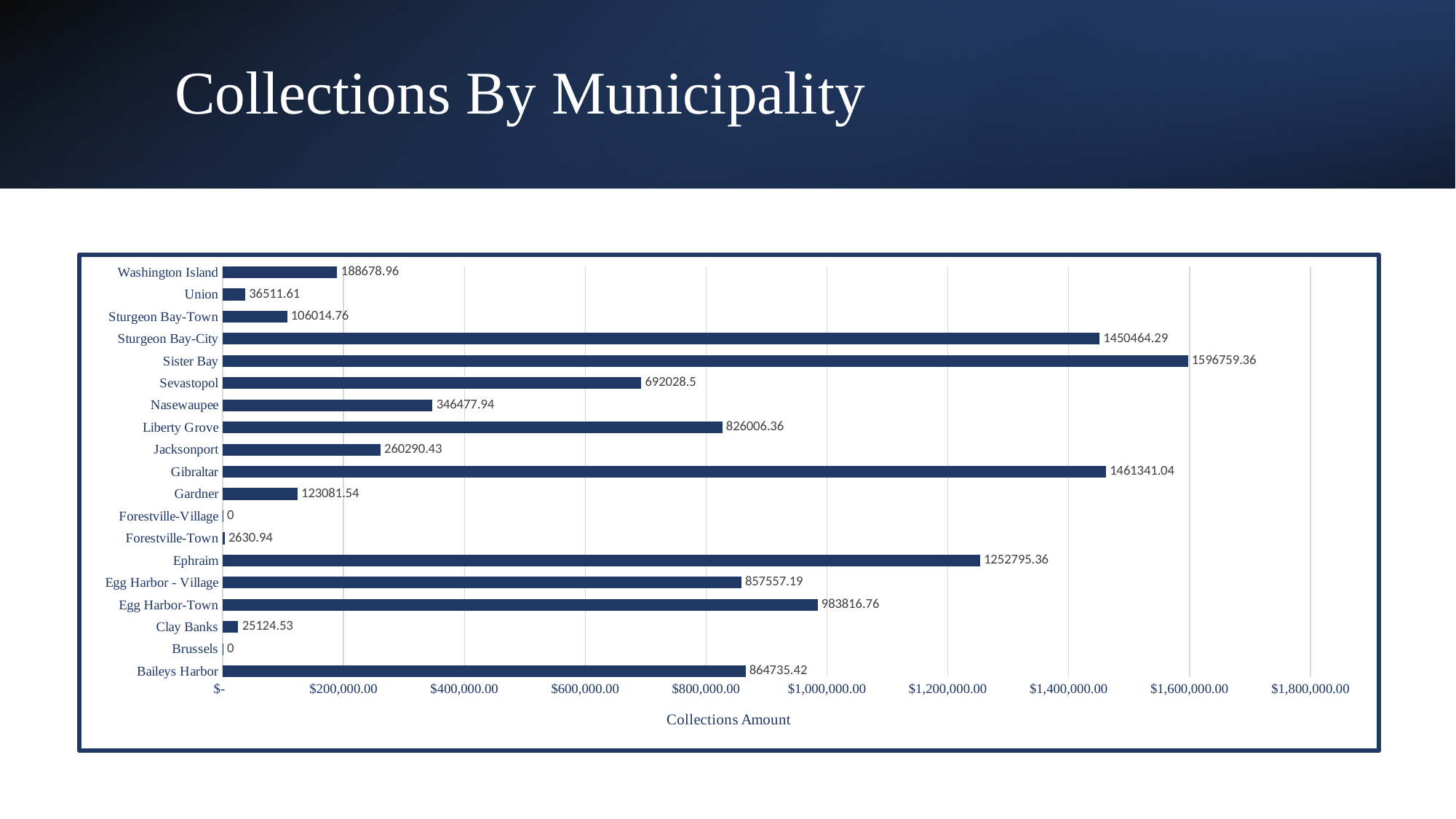
What is the collections amount for Egg Harbor-Town? 983816.76 What is the collections amount for Sister Bay? 1596759.36 What is the collections amount for Forestville-Town? 2630.94 Which has a larger collections amount, Gibraltar or Sturgeon Bay-City? Gibraltar Which municipality has the highest collections amount? Sister Bay What is the difference between the collections amounts for Sister Bay and Sturgeon Bay-City? 146295.07 How many municipalities are shown in the chart? 19 What is the title of the horizontal axis? Collections Amount Which has a larger collections amount, Liberty Grove or Sevastopol? Liberty Grove What is the difference between the collections amounts for Egg Harbor-Town and Egg Harbor - Village? 126259.57 What kind of chart is shown on the slide? Bar chart Is the value for Sevastopol greater or less than $600,000.00? greater